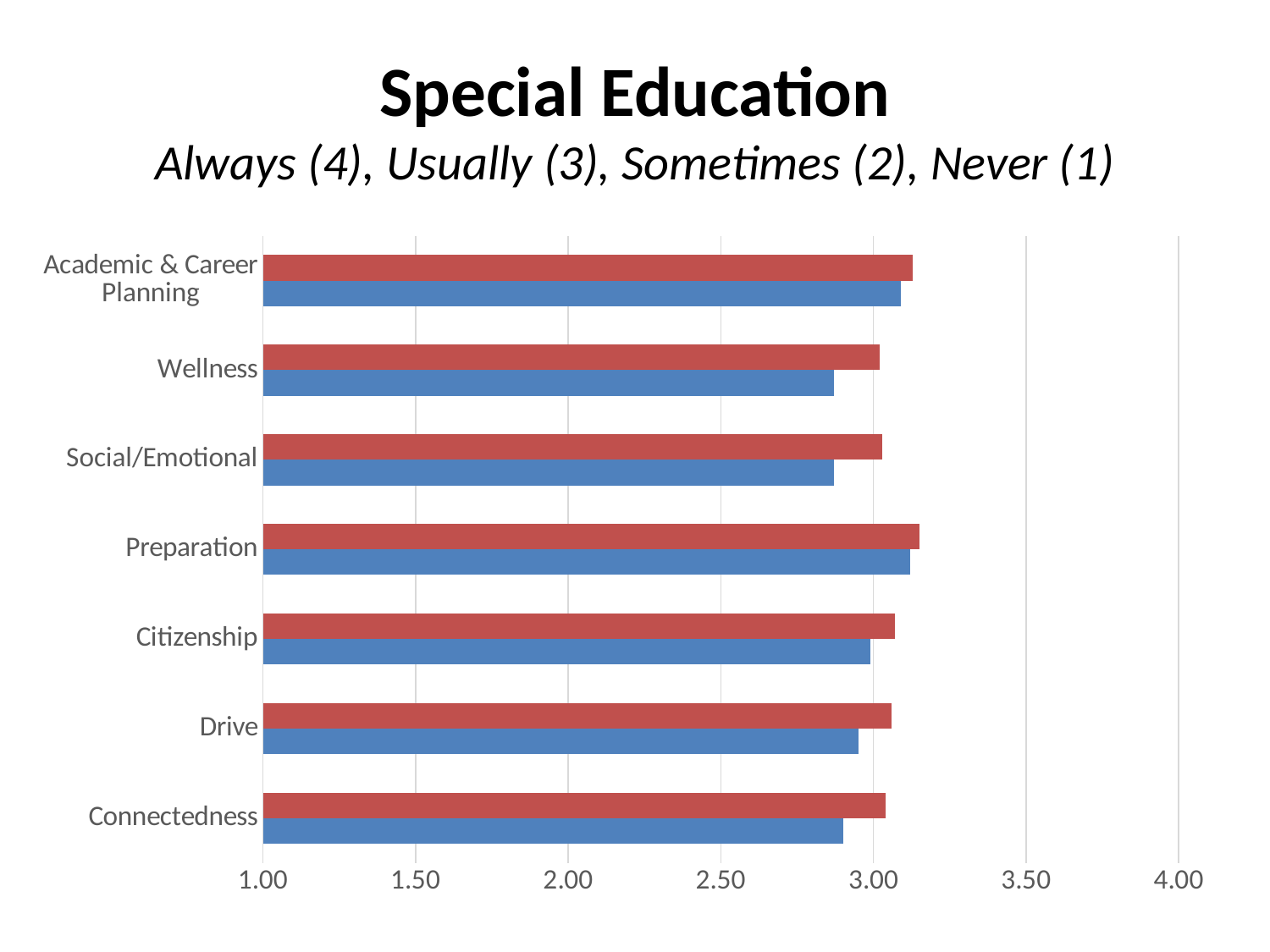
Is the red bar for Academic & Career Planning greater or less than 3.00? greater For Wellness, which bar is longer, the red one or the blue one? red Is the blue bar for Connectedness greater or less than 3.00? less Is the blue bar for Social/Emotional greater or less than 3.00? less What kind of chart is shown on the slide? bar chart For Connectedness, which bar is longer, the red one or the blue one? red What is the highest value shown on the horizontal axis? 4.00 What is the title of the slide? Special Education For Social/Emotional, which bar is longer, the red one or the blue one? red How many categories are shown on the chart? 7